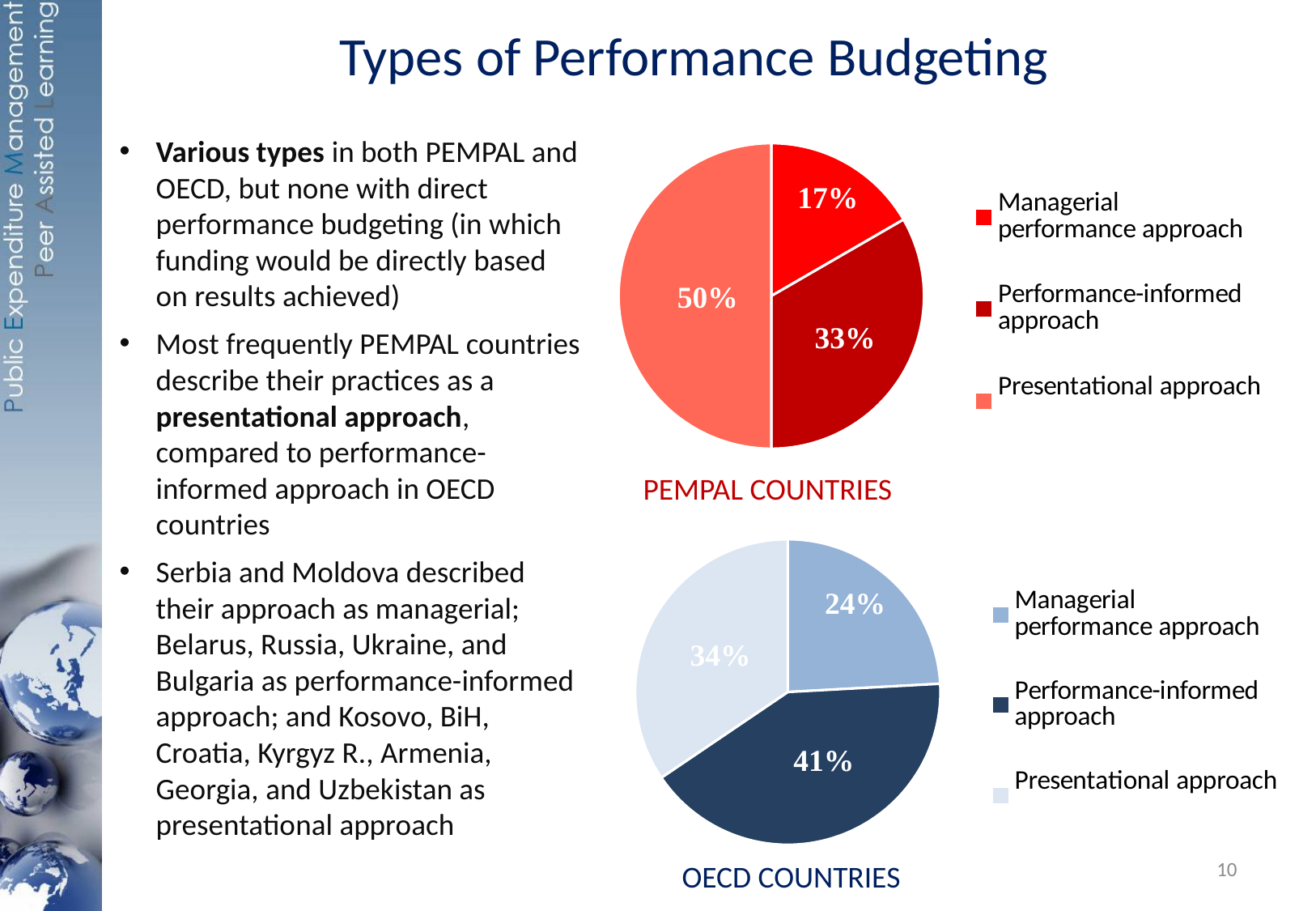
In the PEMPAL COUNTRIES chart, what share is the Presentational approach? 50% In the OECD COUNTRIES chart, what share is the Performance-informed approach? 41% What type of chart is the PEMPAL COUNTRIES chart? Pie chart How many slices does the OECD COUNTRIES pie chart have? 3 In the OECD COUNTRIES chart, which approach has the largest share? Performance-informed approach In the PEMPAL COUNTRIES chart, which approach has the largest share? Presentational approach In the OECD COUNTRIES chart, what is the difference between the Performance-informed approach and the Managerial performance approach shares? 17% In the OECD COUNTRIES chart, which approach has the smallest share? Managerial performance approach In the OECD COUNTRIES chart, what share is the Presentational approach? 34% Which is larger: the Managerial performance approach share in the PEMPAL COUNTRIES chart or in the OECD COUNTRIES chart? OECD COUNTRIES In the PEMPAL COUNTRIES chart, what share is the Managerial performance approach? 17% In the PEMPAL COUNTRIES chart, what is the difference between the Presentational approach and the Performance-informed approach shares? 17%